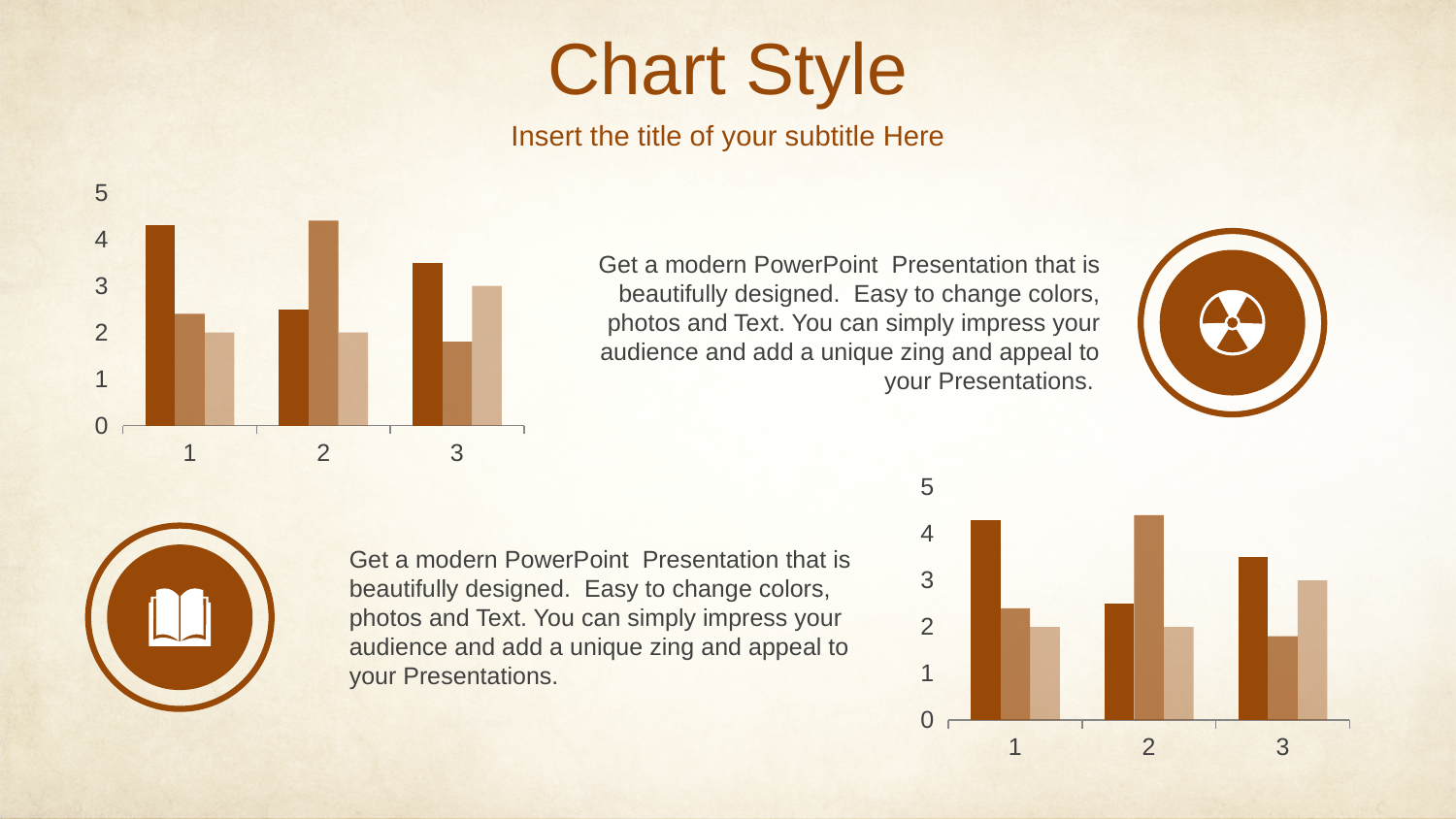
In the top-left chart, which category has the tallest darkest bar? 1 In the top-left chart, how many bars are plotted for each category? 3 In the bottom-right chart, is the value of the darkest bar for category 2 greater or less than 3? less In the bottom-right chart, is the value of the medium-brown bar for category 2 greater or less than 4? greater How many categories are shown on the x axis of the bottom-right chart? 3 In the top-left chart, which category has the shortest medium-brown bar? 3 In the bottom-right chart, which is larger for category 3: the darkest bar or the lightest bar? the darkest bar In the top-left chart, which is larger for category 2: the darkest bar or the medium-brown bar? the medium-brown bar In the bottom-right chart, which category has the tallest medium-brown bar? 2 What kind of chart is the top-left chart? bar chart In the top-left chart, is the value of the medium-brown bar for category 3 greater or less than 2? less